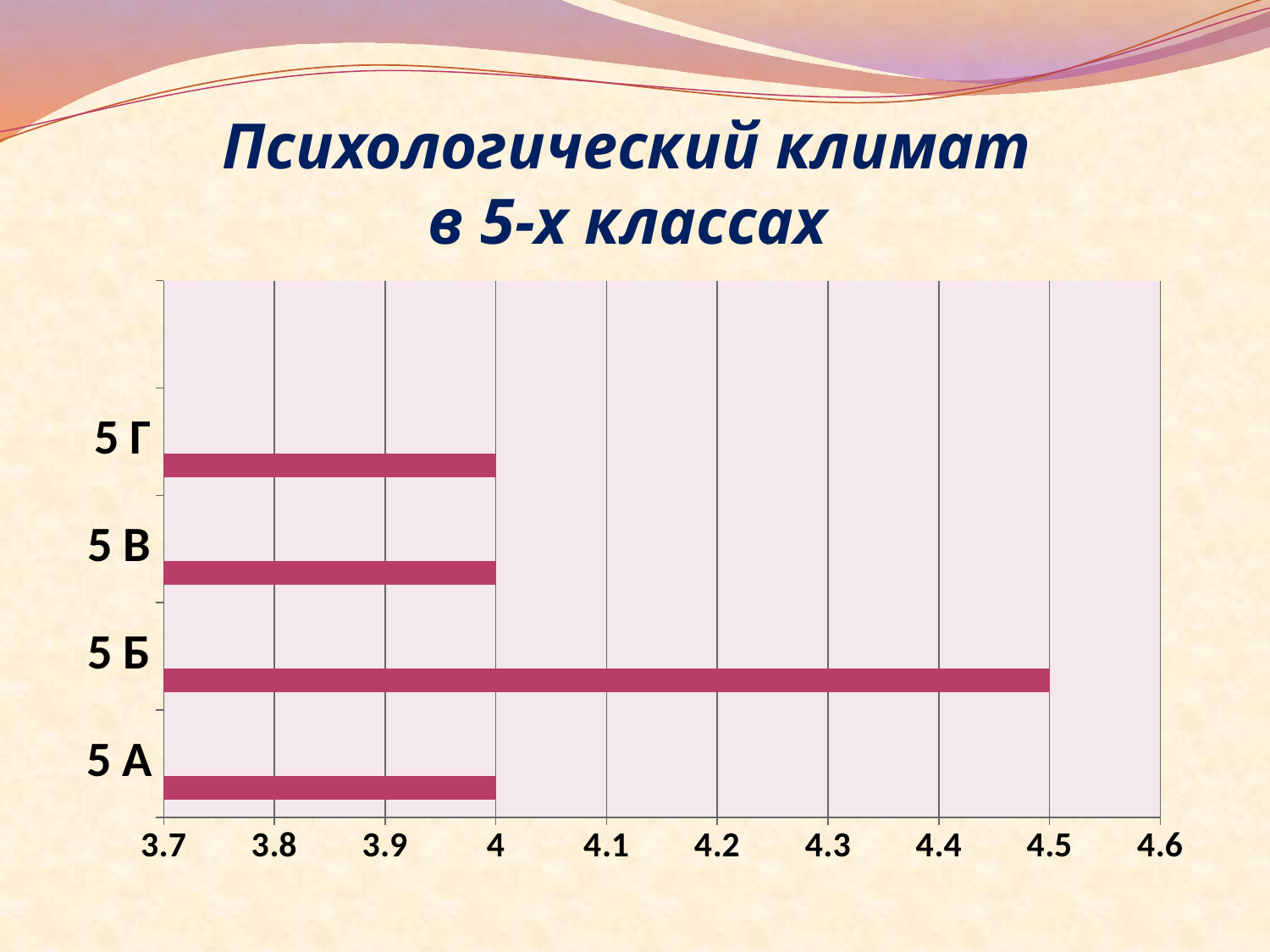
Is the value for 5 Б greater or less than 4.2? greater Which class has the highest value? 5 Б What is the title of the slide? Психологический климат в 5-х классах What is the difference between the values for 5 Б and 5 В? 0.5 What is the value for 5 Г? 4 Is the value for 5 В greater or less than 4.3? less What kind of chart is shown on the slide? bar chart What is the value for 5 А? 4 What is the lowest value shown on the horizontal axis? 3.7 What is the value for 5 Б? 4.5 Which is larger, the value for 5 Б or the value for 5 А? 5 Б How many classes are shown on the chart? 4